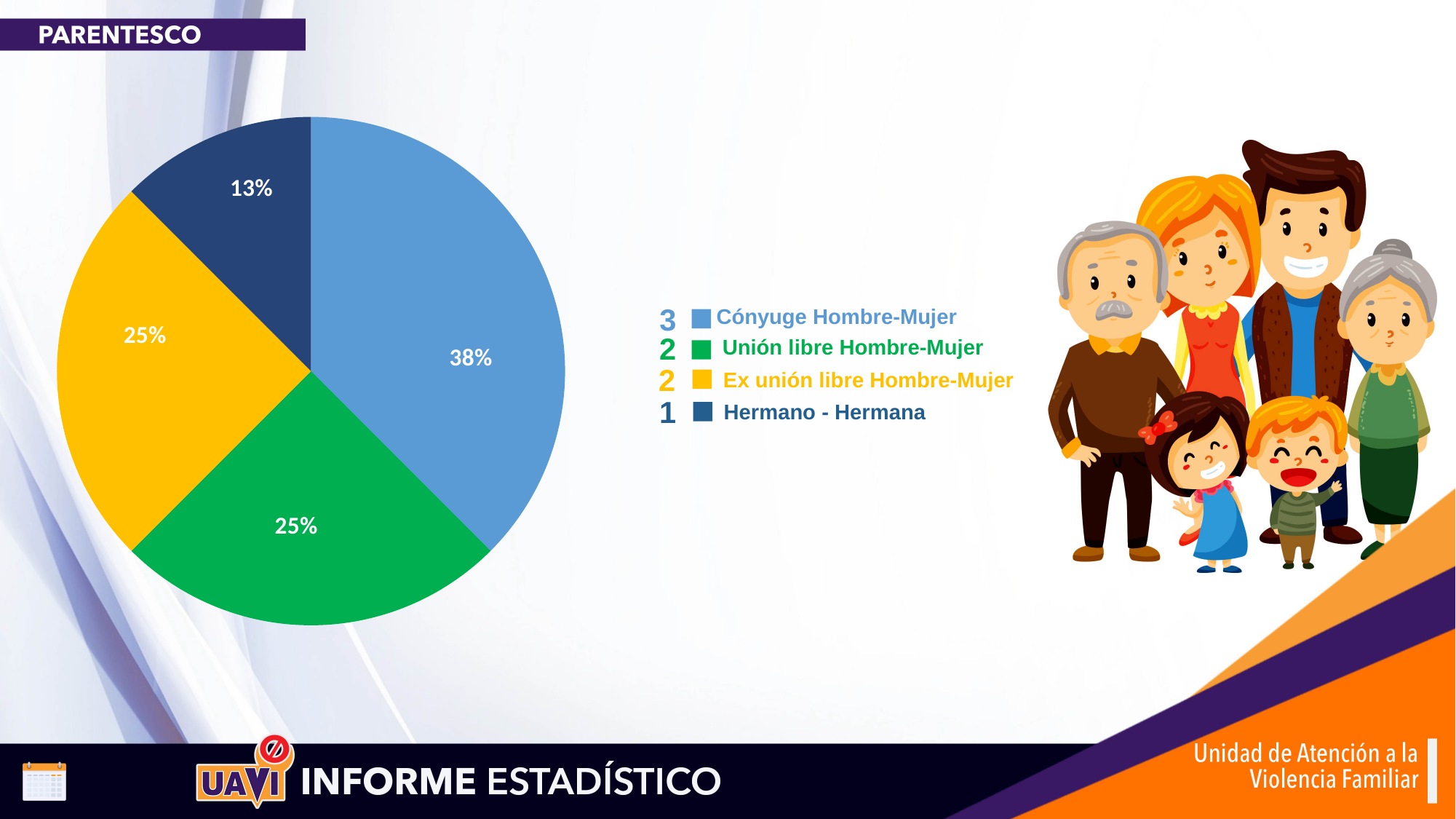
What percentage share does the Unión libre Hombre-Mujer slice have? 25% Which category has the largest slice of the pie? Cónyuge Hombre-Mujer What is the difference in percentage points between the Cónyuge Hombre-Mujer slice and the Hermano - Hermana slice? 25 What percentage share does the Hermano - Hermana slice have? 13% Which category has the smallest slice of the pie? Hermano - Hermana How many slices does the pie chart have? 4 What percentage share does the Cónyuge Hombre-Mujer slice have? 38% What count is listed next to Cónyuge Hombre-Mujer in the legend? 3 What percentage share does the Ex unión libre Hombre-Mujer slice have? 25% Which is larger, the Cónyuge Hombre-Mujer slice or the Unión libre Hombre-Mujer slice? Cónyuge Hombre-Mujer What colour is the Ex unión libre Hombre-Mujer slice? yellow What kind of chart is shown on the slide? pie chart